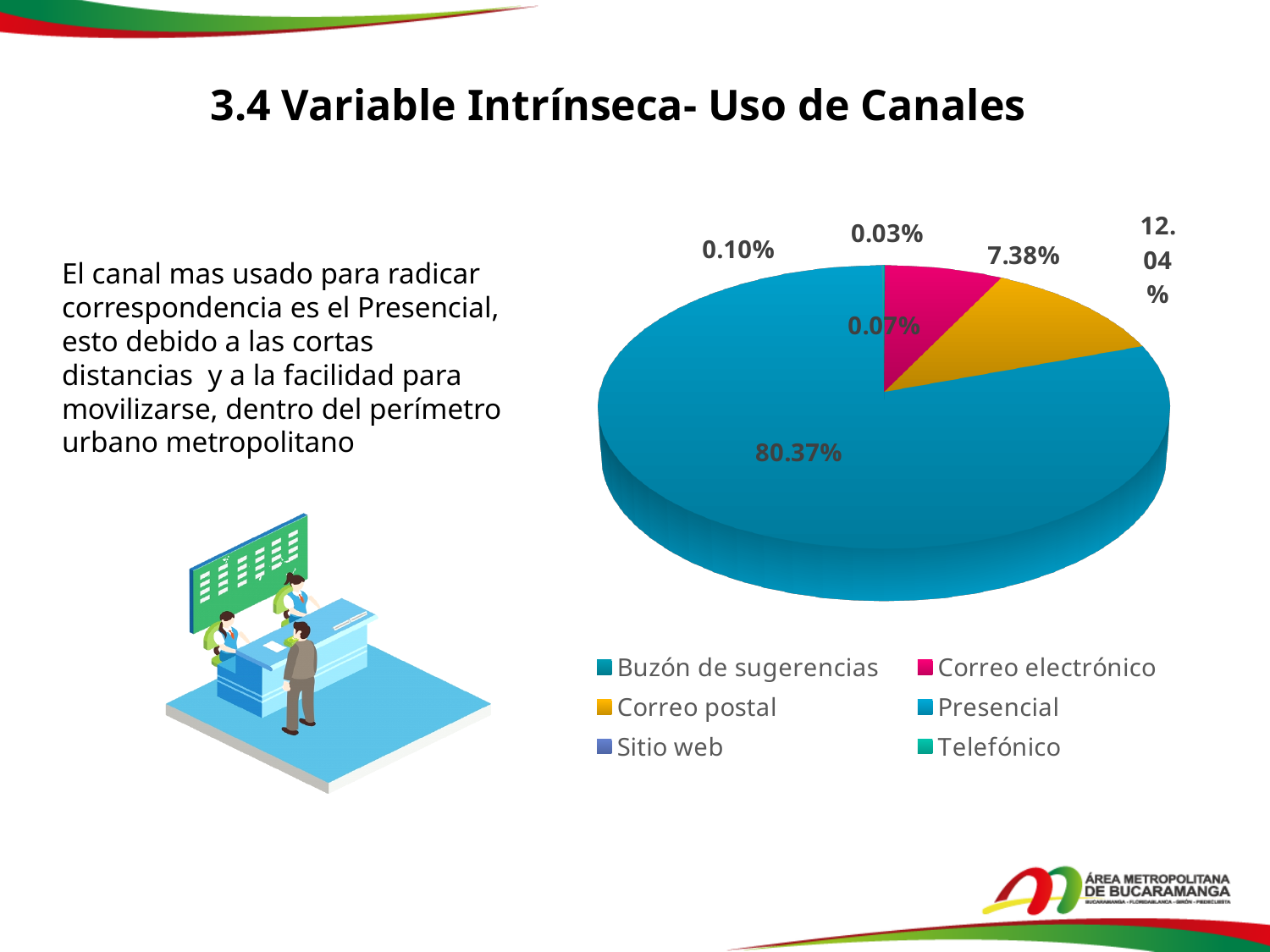
Which is larger, the Correo postal slice or the Correo electrónico slice? Correo postal What is the difference between the Presencial and Correo postal percentages? 68.33% How many categories does the legend of the pie chart list? 6 What kind of chart is shown on the slide? Pie chart What is the smallest percentage value labelled on the pie chart? 0.03% What is the difference between the Correo postal and Correo electrónico percentages? 4.66% What percentage does the Presencial slice show? 80.37% What percentage does the Correo postal slice show? 12.04% What percentage does the Correo electrónico slice show? 7.38% Which channel has the largest slice of the pie? Presencial What share of the pie does the Presencial channel take? 80.37% What colour is the Correo electrónico slice in the pie chart? Magenta (pink)